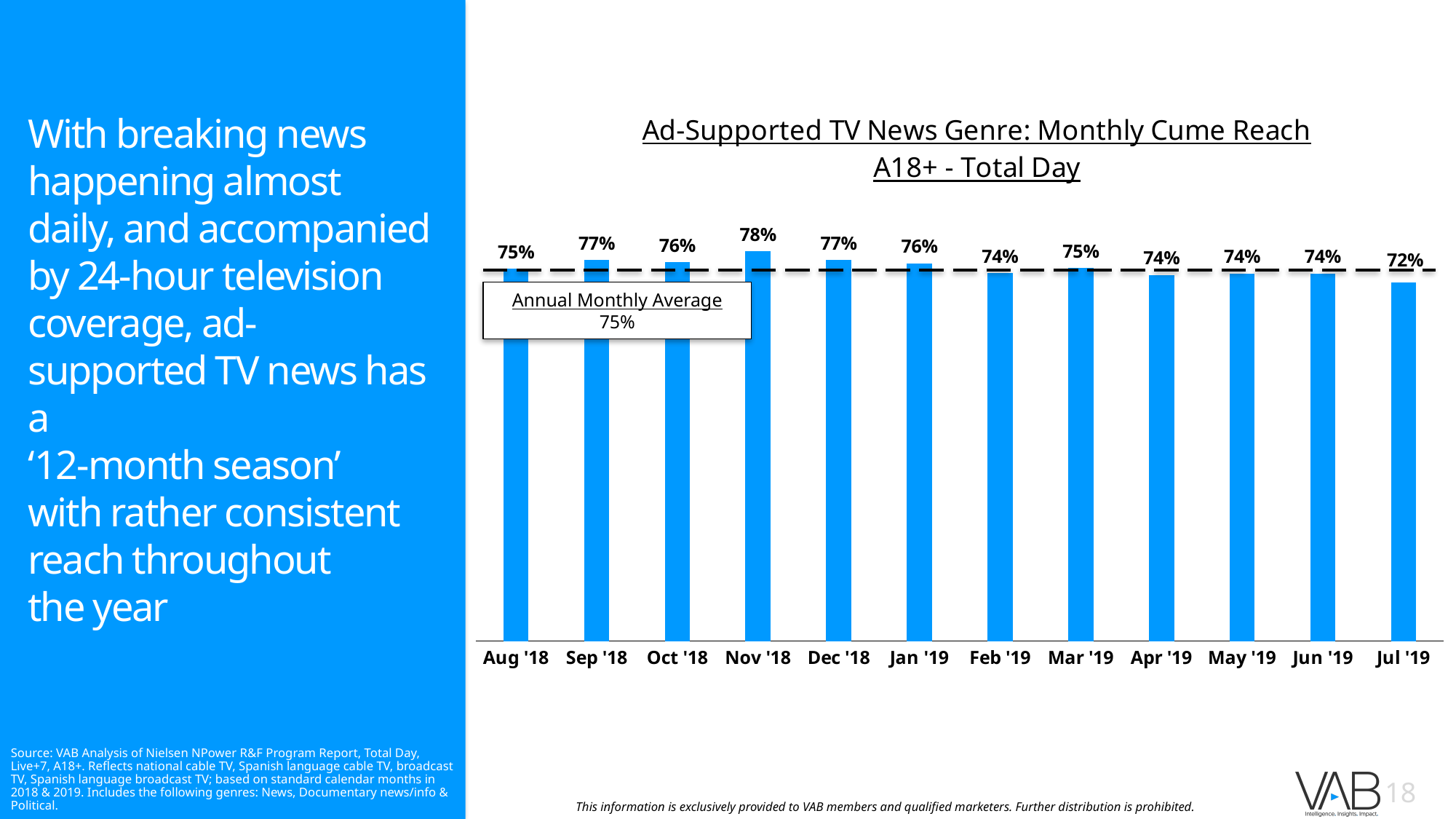
What is the annual monthly average shown on the chart? 75% What kind of chart is shown on the slide? Bar chart What is the title of the chart? Ad-Supported TV News Genre: Monthly Cume Reach A18+ - Total Day How many months are shown on the chart? 12 What is the difference between the reach in Dec '18 and Jan '19? 1% What is the difference between the reach in Nov '18 and Jul '19? 6% Which is larger, the reach in Sep '18 or the reach in Feb '19? Sep '18 Which month has the lowest monthly cume reach? Jul '19 Which month has the highest monthly cume reach? Nov '18 What is the monthly cume reach for Aug '18? 75% What is the monthly cume reach for Jul '19? 72% What is the monthly cume reach for Nov '18? 78%